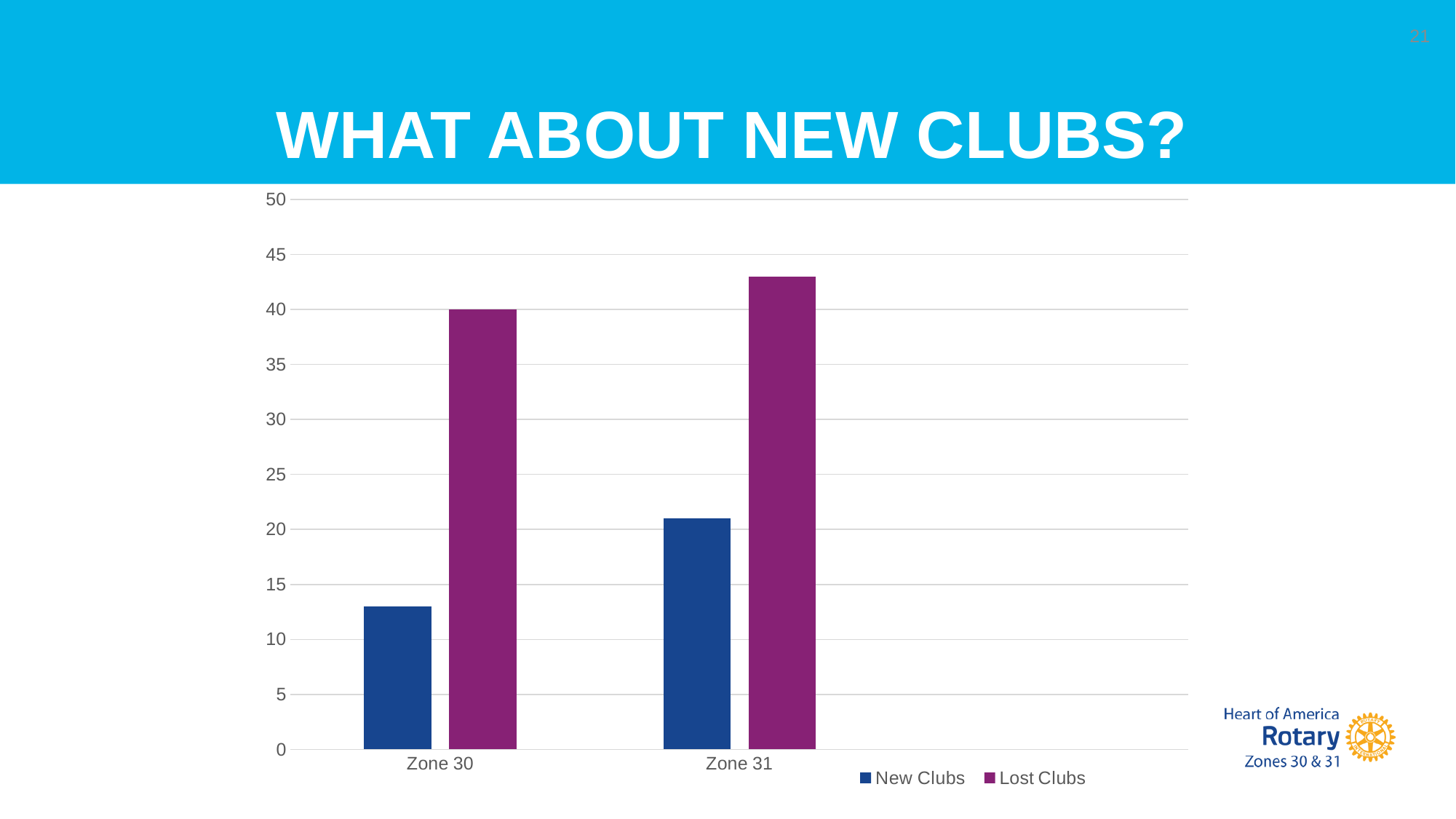
What colour are the Lost Clubs bars? purple Which zone has the lower value for New Clubs? Zone 30 Is the value for New Clubs in Zone 31 greater or less than 20? greater What kind of chart is shown on the slide? bar chart Is the value for Lost Clubs in Zone 31 greater or less than 40? greater Which zone has the higher value for Lost Clubs? Zone 31 What is the value for Lost Clubs in Zone 30? 40 In Zone 31, which is larger: New Clubs or Lost Clubs? Lost Clubs How many series does the legend list? 2 How many categories are shown on the x axis? 2 Is the value for New Clubs in Zone 30 greater or less than 15? less Which bar is the tallest in the chart? Lost Clubs in Zone 31